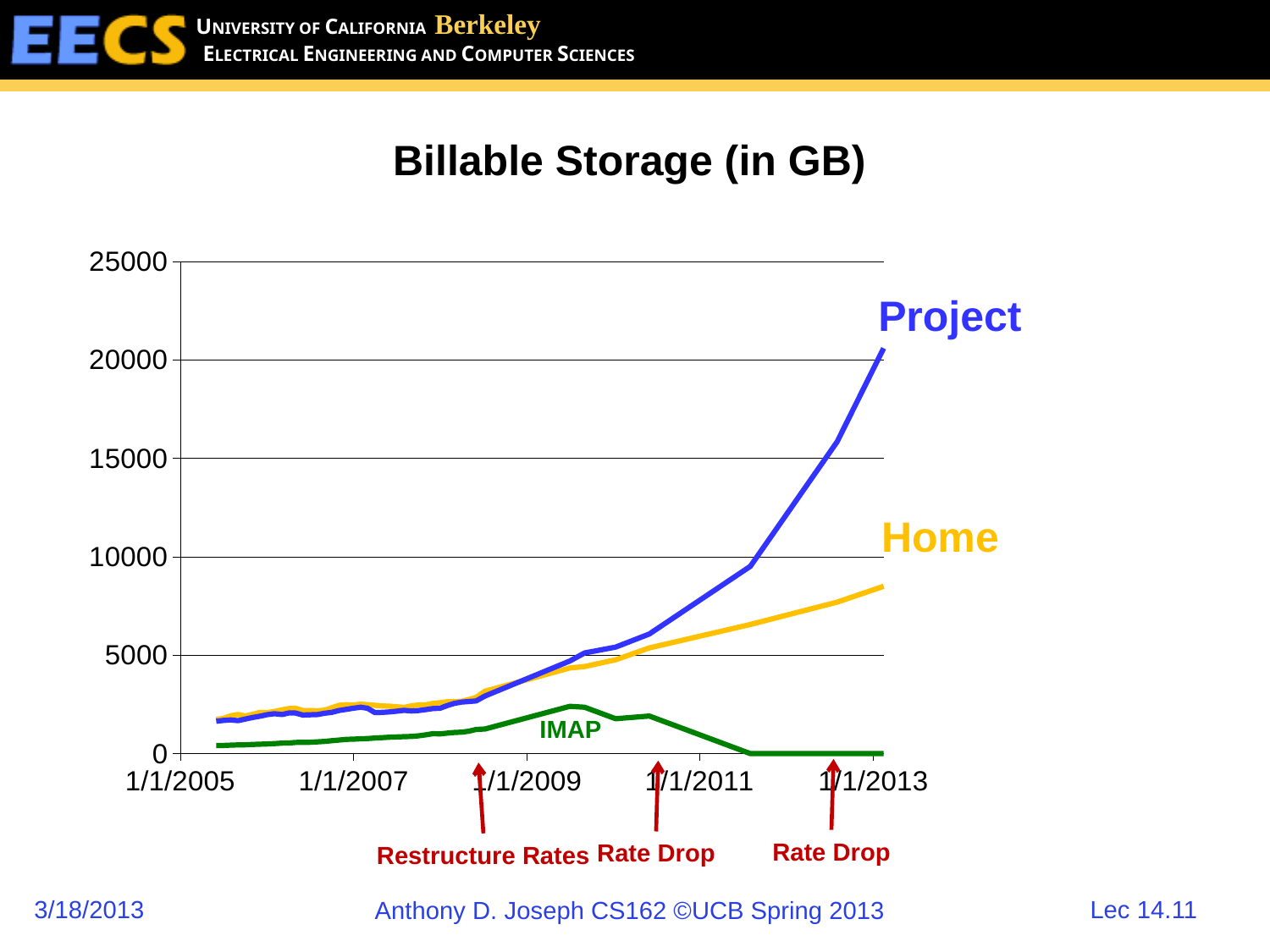
What colour is the Home line in the chart? Yellow Is the value for Project at 1/1/2013 greater or less than 15000? greater Does the Project series rise or fall from 1/1/2005 to 1/1/2013? Rises How many data series are plotted in the chart? 3 At 1/1/2013, which is larger, the Project value or the Home value? Project What kind of chart is shown on the slide? Line chart Is the value for Home at 1/1/2013 greater or less than 10000? less Is the value for IMAP at 1/1/2013 greater or less than 5000? less Does the IMAP series rise or fall between 1/1/2011 and 1/1/2013? Falls What is the title of the chart? Billable Storage (in GB) Which series has the lowest value at 1/1/2013? IMAP Which series has the highest value at 1/1/2013? Project